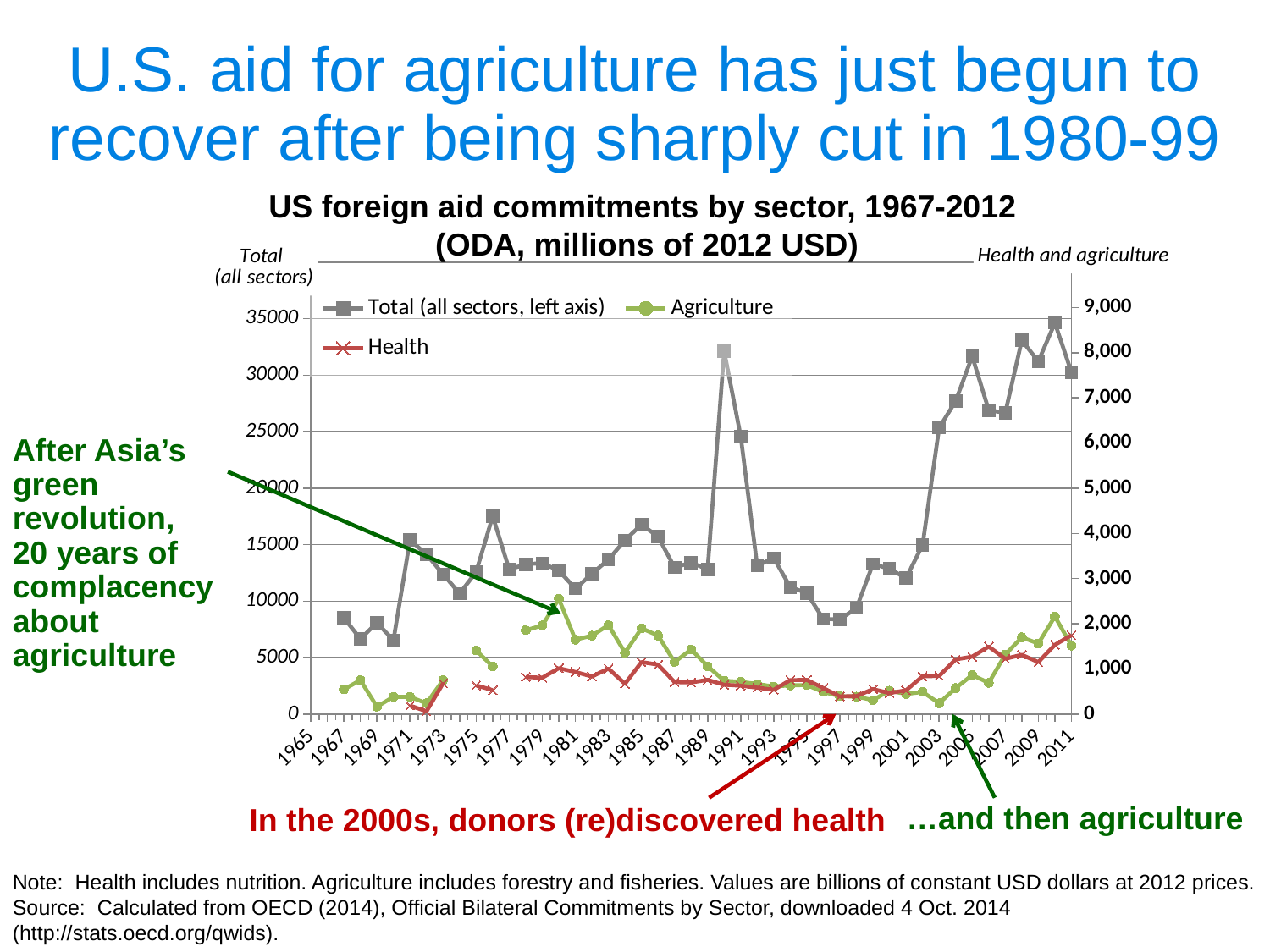
Is the Total (all sectors) value for 1997 greater or less than 10000? less Is the Total (all sectors) value for 1991 greater or less than 30000? less Is the Agriculture value for 2004 greater or less than 1,000? less In 1980, which series has the larger value, Agriculture or Health? Agriculture Does the Agriculture series rise or fall between 1980 and 1999? fall How many series does the chart legend list? 3 Which series is plotted on the left axis according to the legend? Total (all sectors, left axis) Does the Health series rise or fall between 2000 and 2011? rise What is the title of the chart? US foreign aid commitments by sector, 1967-2012 (ODA, millions of 2012 USD) What kind of chart is shown on the slide? line chart